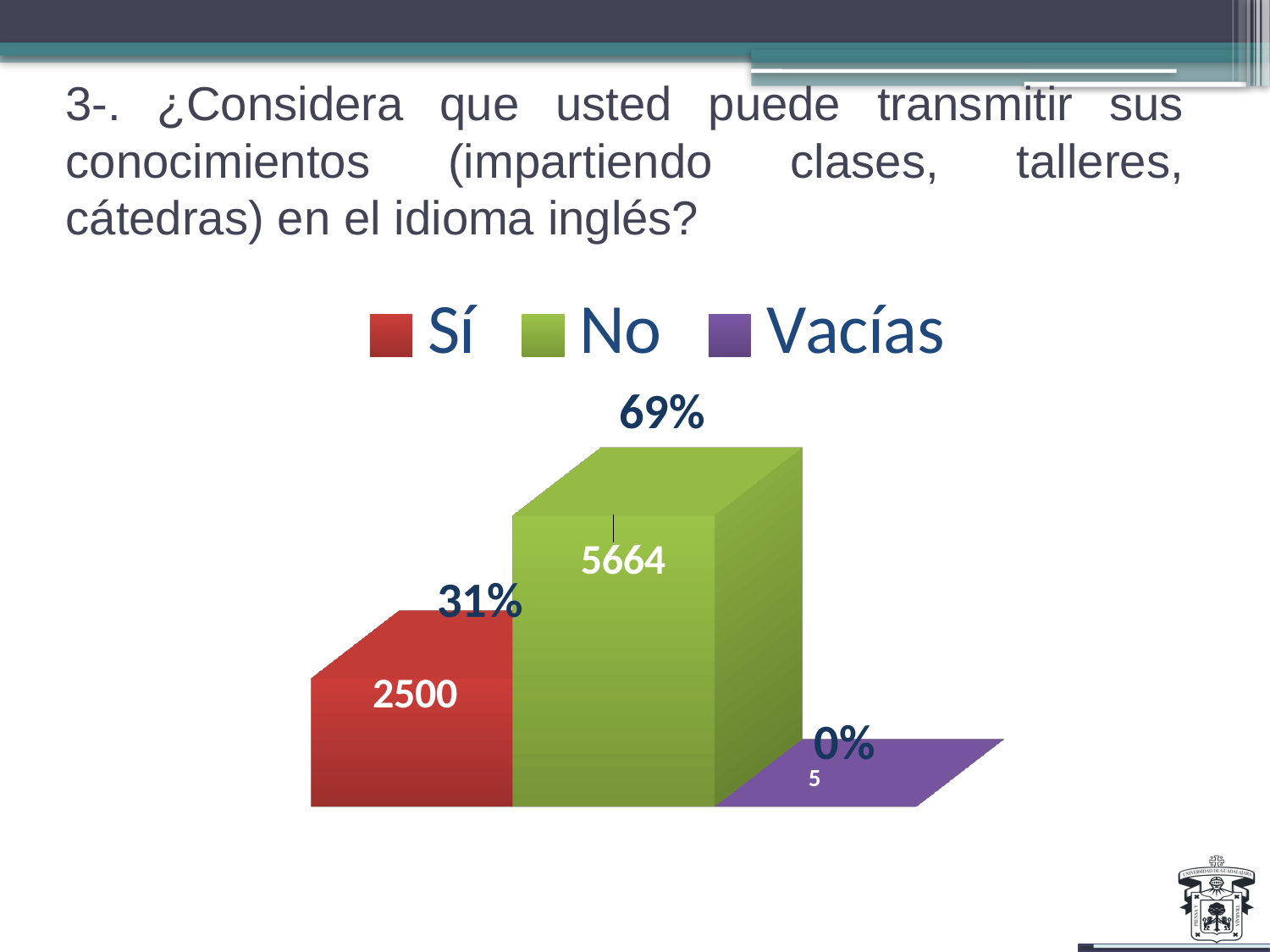
What kind of chart is shown on the slide? Bar chart What value is shown for the "No" bar? 5664 What value is shown for the "Sí" bar? 2500 What value is shown for the "Vacías" bar? 5 Which category has the lowest value? Vacías Which category has the highest value? No How many categories does the chart show? 3 Which is larger, the value for "Sí" or the value for "No"? No What percentage is shown for "Sí"? 31% What is the difference between the values for "No" and "Sí"? 3164 How many entries does the legend list? 3 What percentage is shown for "No"? 69%